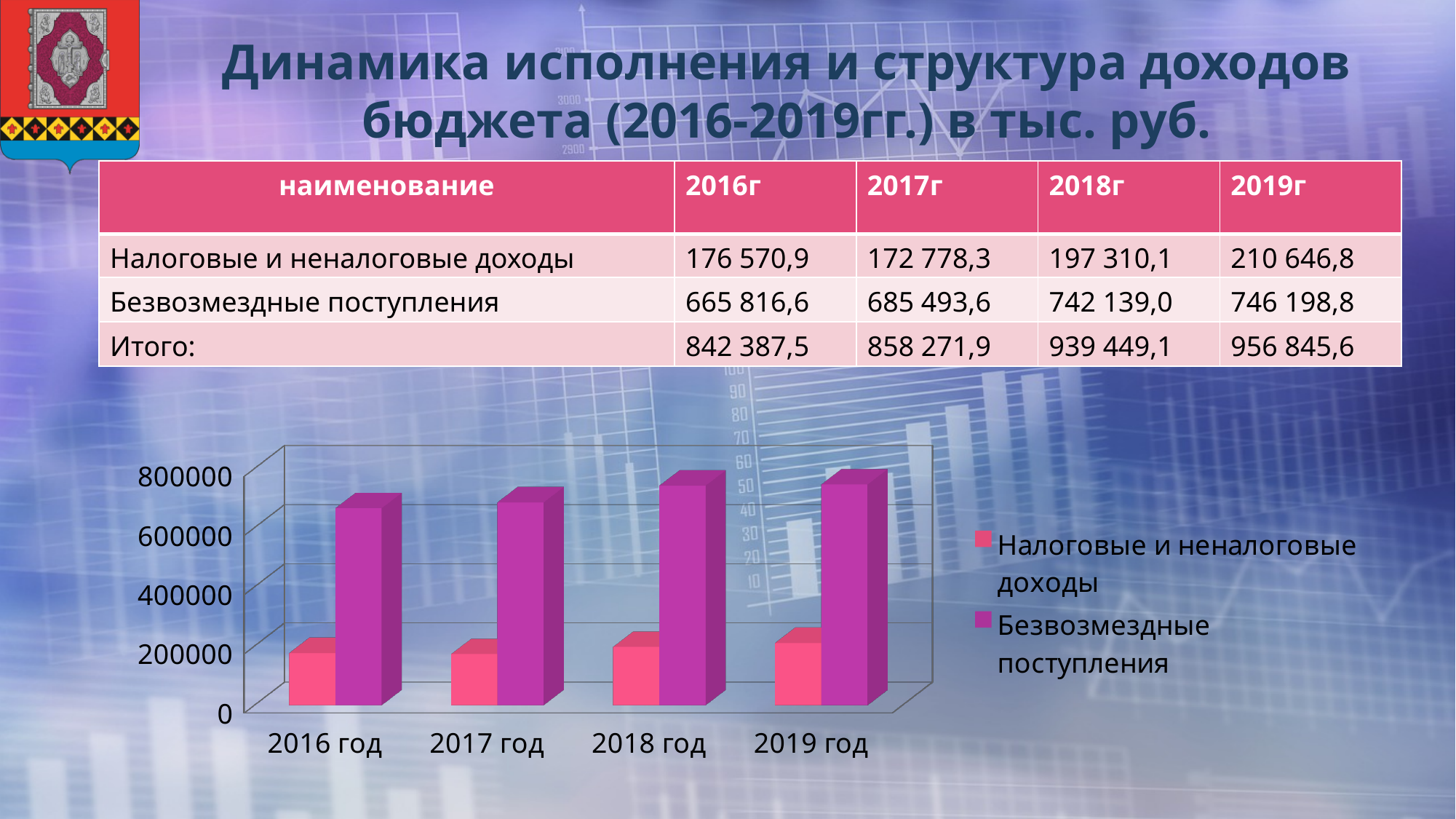
Do the values for Безвозмездные поступления rise or fall from 2016 год to 2019 год? rise How many series does the chart legend list? 2 According to the table on the slide, what is the value of Безвозмездные поступления for 2018г? 742 139,0 Is the value for Безвозмездные поступления in 2019 год greater or less than 800000? less Is the value for Безвозмездные поступления in 2016 год greater or less than 600000? greater How many years (categories) are shown on the x axis of the chart? 4 Which series is shown in purple in the chart? Безвозмездные поступления Is the value for Налоговые и неналоговые доходы in 2016 год greater or less than 200000? less In 2017 год, which series has the larger value: Налоговые и неналоговые доходы or Безвозмездные поступления? Безвозмездные поступления According to the table on the slide, what is the value of Налоговые и неналоговые доходы for 2019г? 210 646,8 What kind of chart is shown on the slide? bar chart